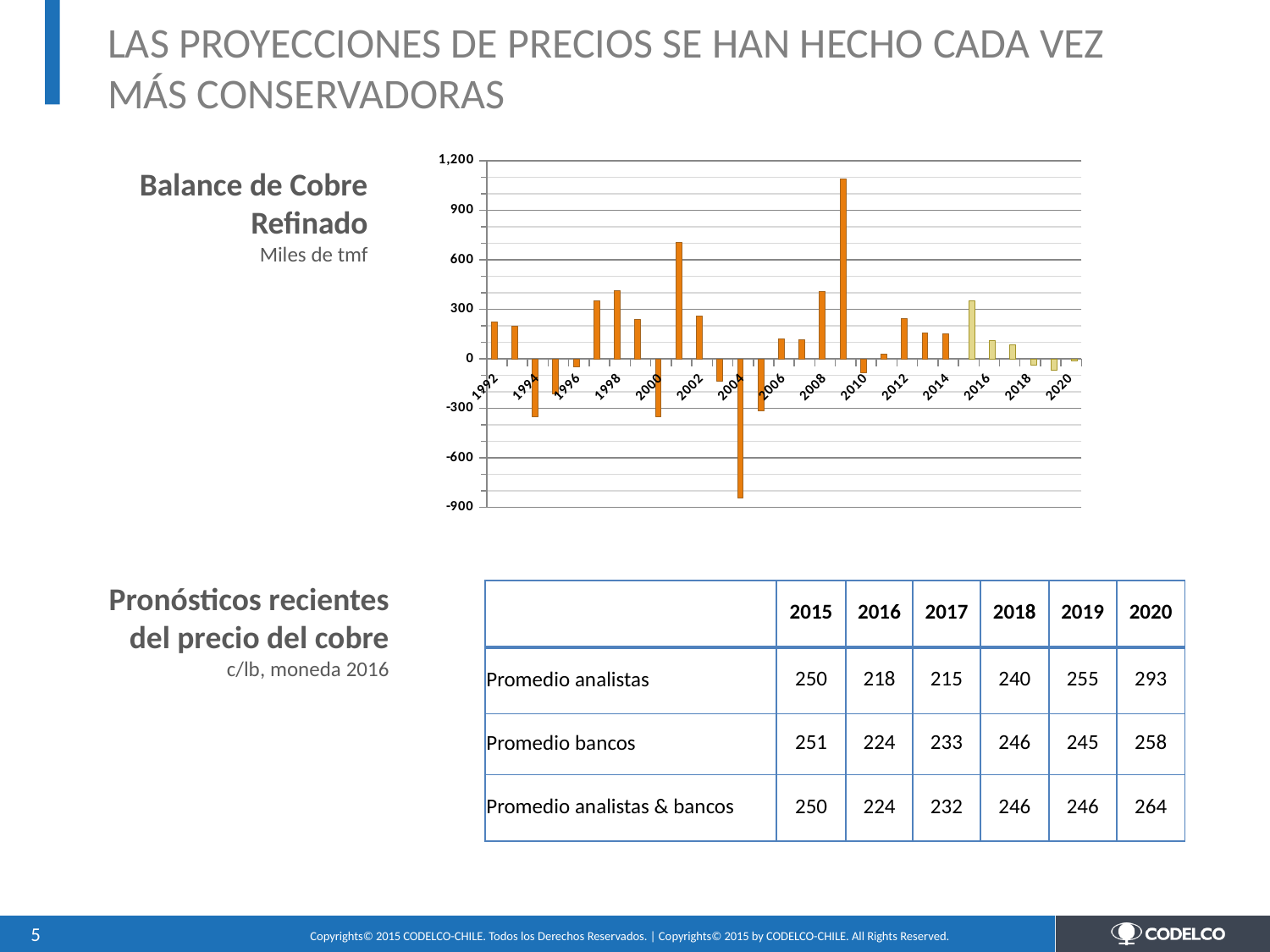
In the 'Balance de Cobre Refinado' chart, is the value for 1998 greater or less than 300? greater In the 'Balance de Cobre Refinado' chart, is the value for 2012 greater or less than 300? less What unit is given under the title of the 'Balance de Cobre Refinado' chart? Miles de tmf In the 'Balance de Cobre Refinado' chart, which is lower, the value for 1994 or the value for 2004? 2004 In the 'Balance de Cobre Refinado' chart, is the value for 2004 greater or less than -600? less In the 'Balance de Cobre Refinado' chart, which year has the lowest value? 2004 What kind of chart is the 'Balance de Cobre Refinado' chart? bar chart What is the highest tick value shown on the y axis of the 'Balance de Cobre Refinado' chart? 1,200 In the 'Balance de Cobre Refinado' chart, which is larger, the value for 1998 or the value for 2002? 1998